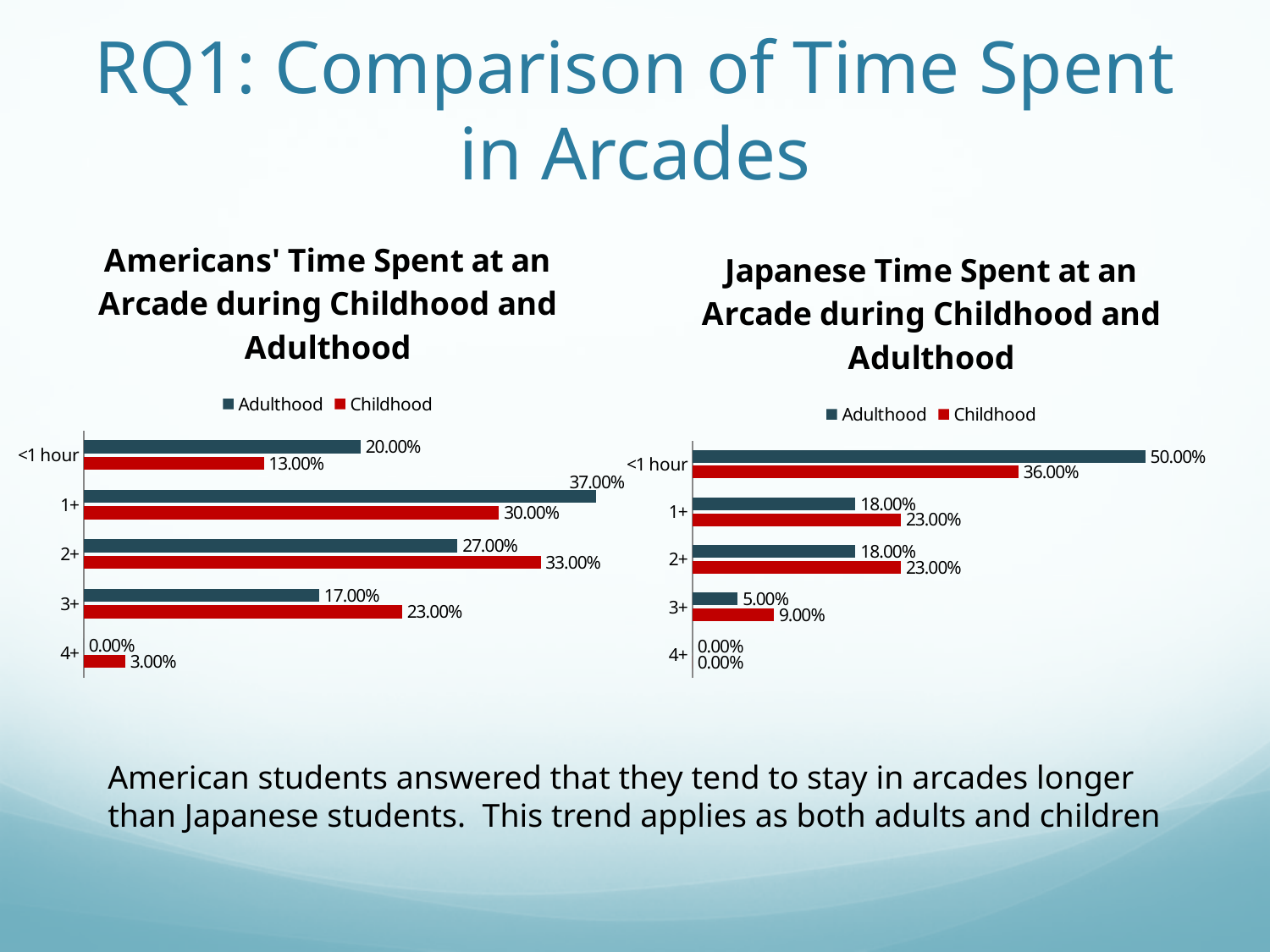
In the Americans' Time Spent at an Arcade chart, which colour represents the Childhood series? Red In the Japanese Time Spent at an Arcade chart, which category has the lowest Childhood value? 4+ In the Americans' Time Spent at an Arcade chart, what is the difference between the Adulthood value for 1+ and the Adulthood value for <1 hour? 17.00% In the Japanese Time Spent at an Arcade chart, what is the Childhood value for <1 hour? 36.00% What kind of chart is the Japanese Time Spent at an Arcade chart? Bar chart In the Americans' Time Spent at an Arcade chart, what is the difference between the Adulthood and Childhood values for 3+? 6.00% In the Japanese Time Spent at an Arcade chart, what is the Adulthood value for 3+? 5.00% In the Americans' Time Spent at an Arcade chart, which category has the highest Childhood value? 2+ In the Americans' Time Spent at an Arcade chart, what is the Adulthood value for 1+? 37.00% How many categories are shown in the Americans' Time Spent at an Arcade chart? 5 How many series does the legend of the Japanese Time Spent at an Arcade chart list? 2 In the Japanese Time Spent at an Arcade chart, which is larger for 2+: the Adulthood value or the Childhood value? Childhood